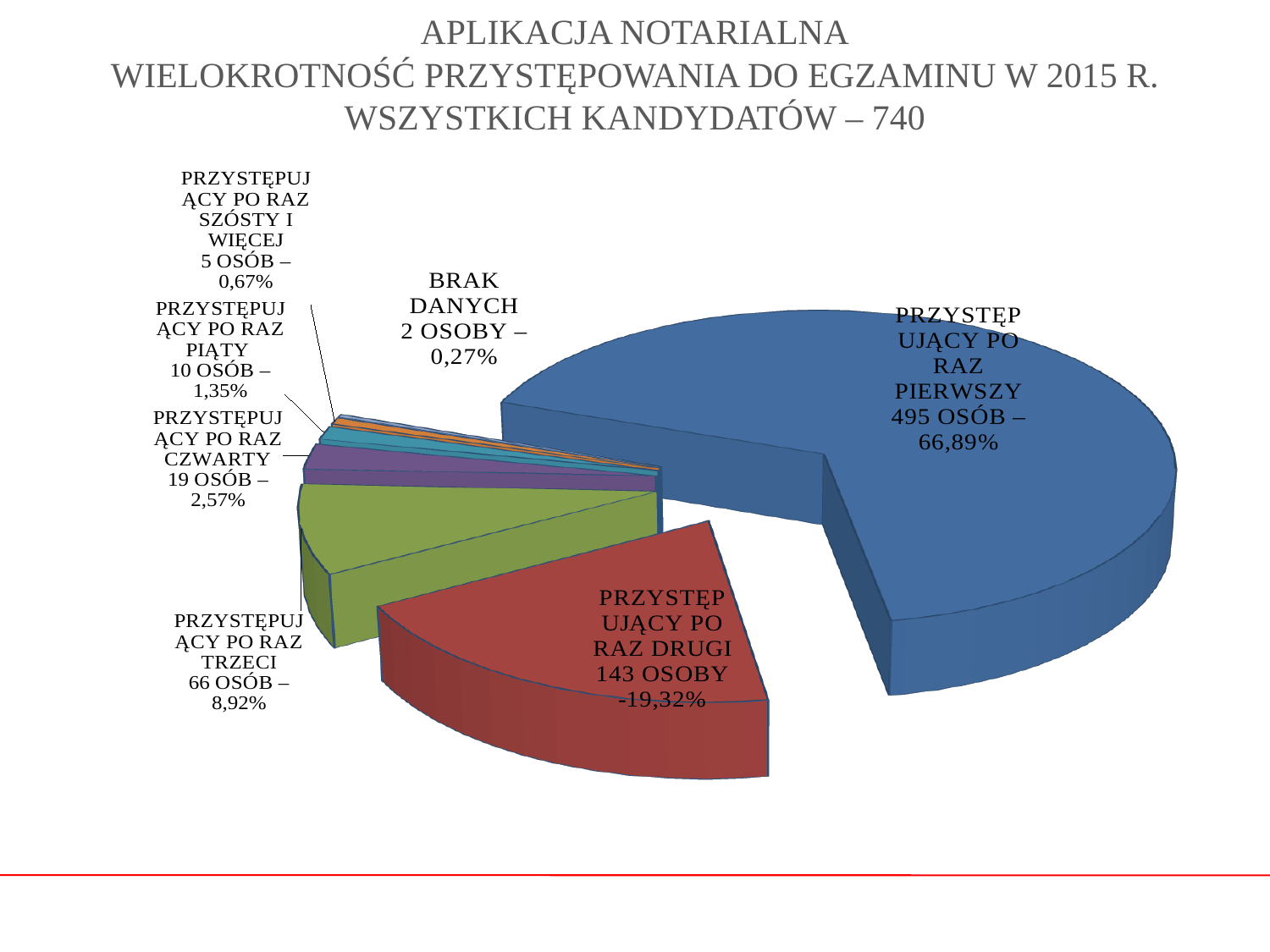
How many slices does the pie chart have? 7 How many candidates took the exam for the third time (PRZYSTĘPUJĄCY PO RAZ TRZECI)? 66 OSÓB What kind of chart is shown on the slide? pie chart What percentage is shown for candidates taking the exam for the fourth time (PRZYSTĘPUJĄCY PO RAZ CZWARTY)? 2,57% What percentage share is shown for candidates taking the exam for the second time (PRZYSTĘPUJĄCY PO RAZ DRUGI)? 19,32% How many candidates took the exam for the first time (PRZYSTĘPUJĄCY PO RAZ PIERWSZY)? 495 OSÓB Which category has the largest slice of the pie? PRZYSTĘPUJĄCY PO RAZ PIERWSZY Which is larger: the number of candidates taking the exam for the fifth time or for the sixth time and more? fifth time (10 OSÓB) Which category has the smallest slice of the pie? BRAK DANYCH What total number of candidates is given in the chart title? 740 How many candidates are in the BRAK DANYCH (no data) category? 2 OSOBY What is the difference in the number of candidates between those taking the exam for the first time and those taking it for the second time? 352